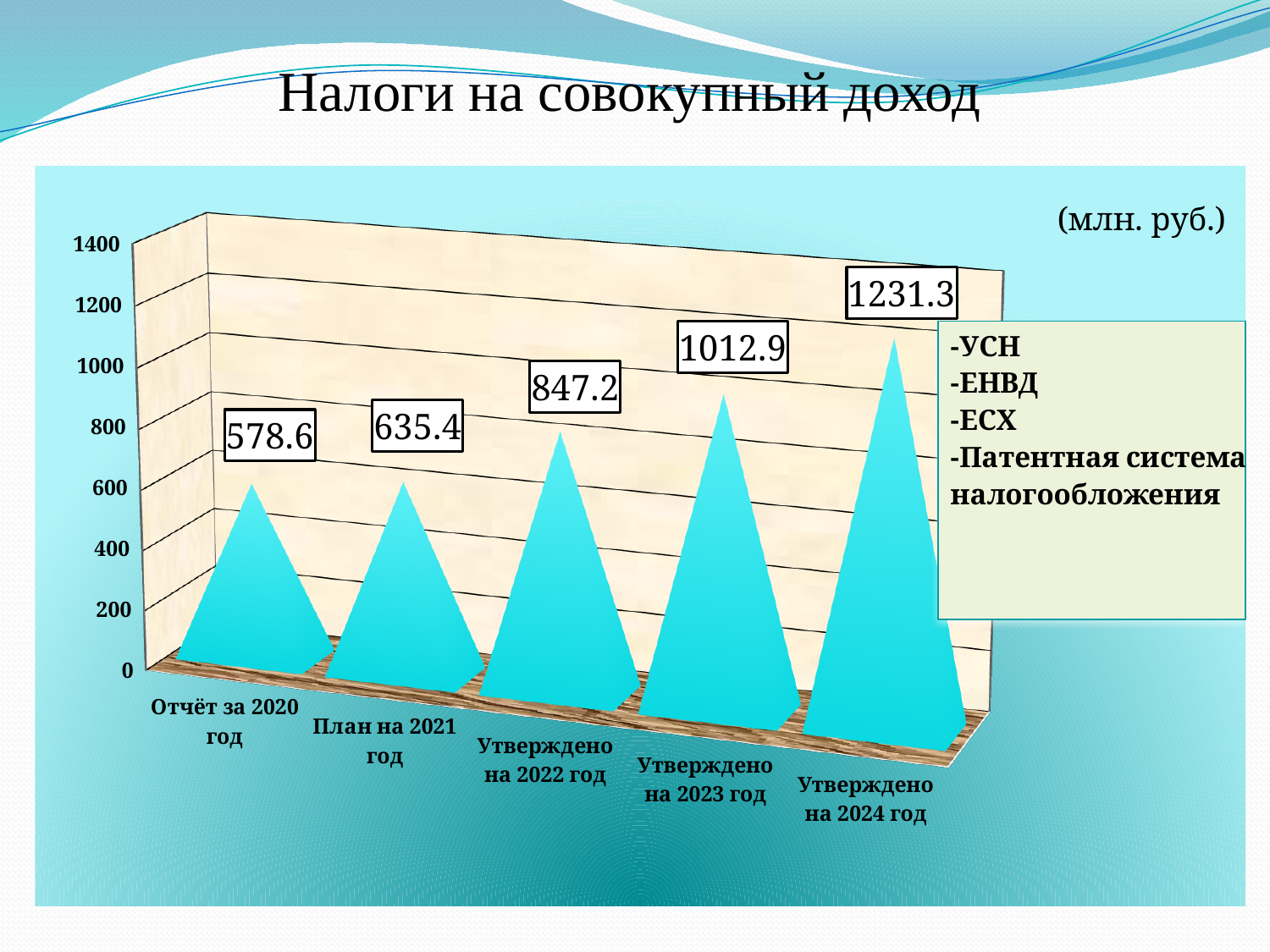
Which category has the lowest value? Отчёт за 2020 год What is the value for "План на 2021 год"? 635.4 Which category has the highest value? Утверждено на 2024 год What is the value for "Утверждено на 2024 год"? 1231.3 What is the value for "Утверждено на 2022 год"? 847.2 What unit is stated for the chart values? млн. руб. Do the values rise or fall from left to right along the x axis? rise How many categories are shown on the chart? 5 Which is larger: the value for "План на 2021 год" or the value for "Утверждено на 2022 год"? Утверждено на 2022 год What is the value for "Отчёт за 2020 год"? 578.6 What is the difference between the values for "Утверждено на 2024 год" and "Утверждено на 2023 год"? 218.4 Is the value for "Утверждено на 2023 год" greater or less than 1000? greater